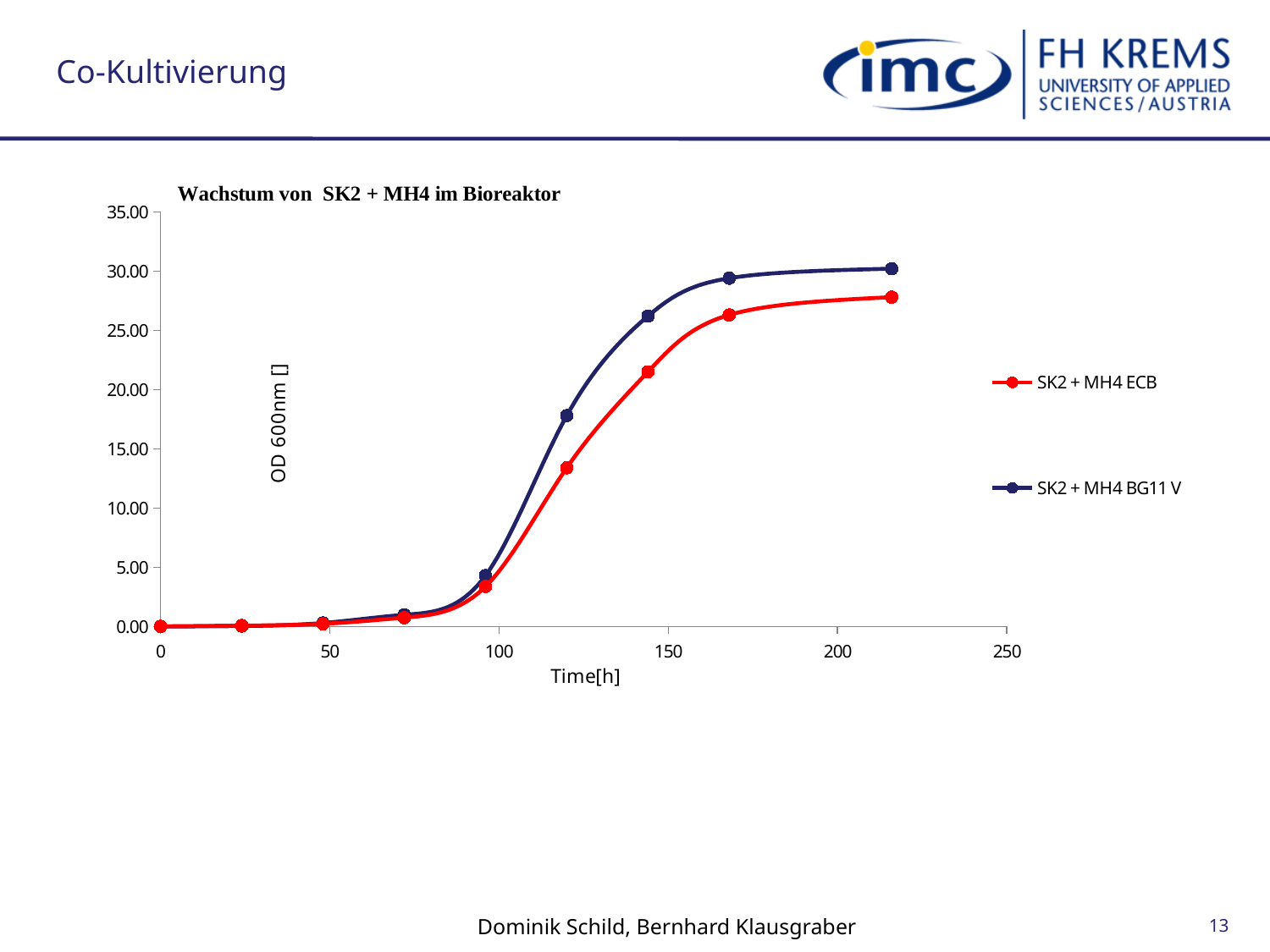
Is the value of SK2 + MH4 BG11 V at around 120 h greater or less than 15.00? greater Is the final value of SK2 + MH4 BG11 V greater or less than 25.00? greater Is the value of SK2 + MH4 ECB at around 120 h greater or less than 15.00? less What kind of chart is shown on the slide? line chart How many data points are plotted for the SK2 + MH4 BG11 V series? 9 Which series reaches the higher OD 600nm value at the end of the measurement? SK2 + MH4 BG11 V What is the label of the x axis? Time[h] At around 120 h, which series has the higher OD 600nm value, SK2 + MH4 ECB or SK2 + MH4 BG11 V? SK2 + MH4 BG11 V What is the title of the chart? Wachstum von SK2 + MH4 im Bioreaktor Do the OD 600nm values of SK2 + MH4 ECB rise or fall as time increases? rise How many series does the legend list? 2